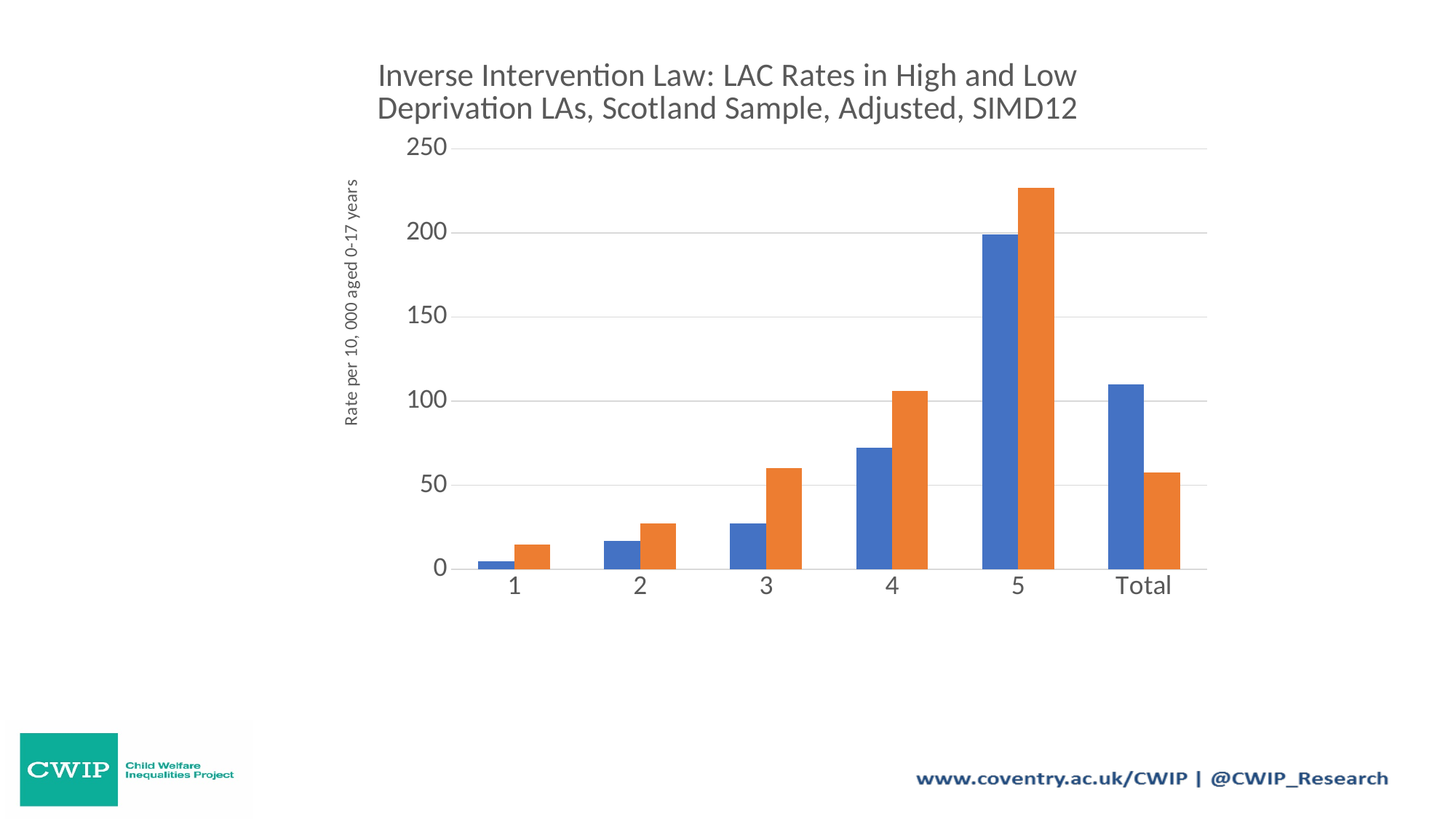
Is the value of the orange bar for category 5 greater or less than 200? greater What kind of chart is shown on the slide? bar chart How many categories are shown on the x axis? 6 How many bars are plotted for each category on the x axis? 2 What is the label on the vertical axis of the chart? Rate per 10, 000 aged 0-17 years Is the value of the blue bar for Total greater or less than 100? greater Is the value of the orange bar for category 3 greater or less than 50? greater Among categories 1 to 5, which category has the highest blue bar? 5 For Total, which bar is taller, the blue bar or the orange bar? blue For category 5, which bar is taller, the blue bar or the orange bar? orange Do the values rise or fall from category 1 to category 5? rise